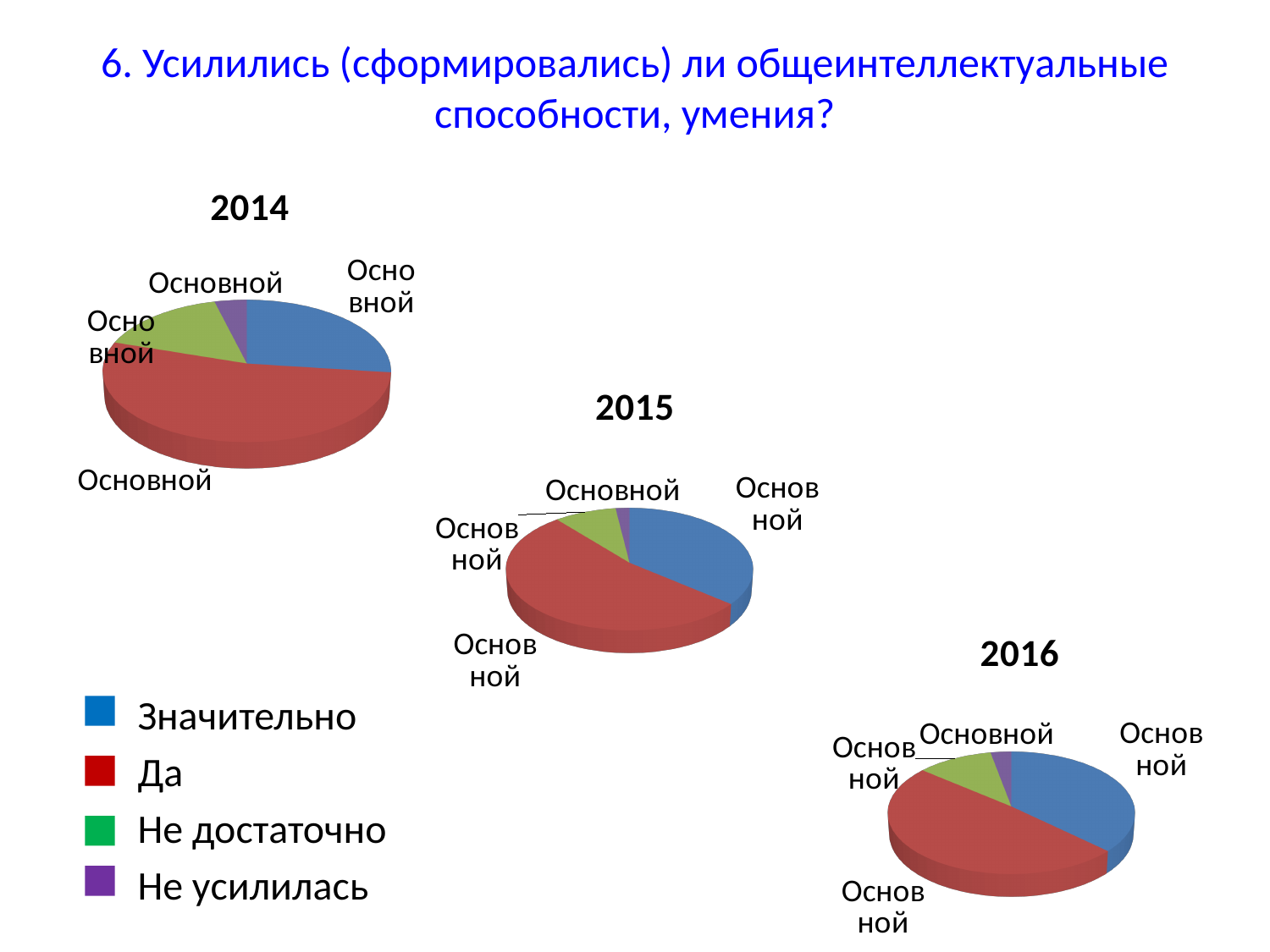
Which colour represents the category Да in the legend? red In the 2016 pie chart, which category has the smallest slice? Не усилилась What is the title of the pie chart at the bottom right of the slide? 2016 In the 2014 pie chart, which category has the largest slice? Да How many pie charts are shown on the slide? 3 In the 2016 pie chart, which slice is larger: Да or Значительно? Да How many slices does the 2015 pie chart have? 4 In the 2014 pie chart, which slice is larger: Значительно or Не достаточно? Значительно In the 2015 pie chart, which slice is smaller: Не достаточно or Не усилилась? Не усилилась How many entries does the legend on the slide list? 4 In the 2015 pie chart, which category has the largest slice? Да What kind of chart is the 2014 chart? pie chart